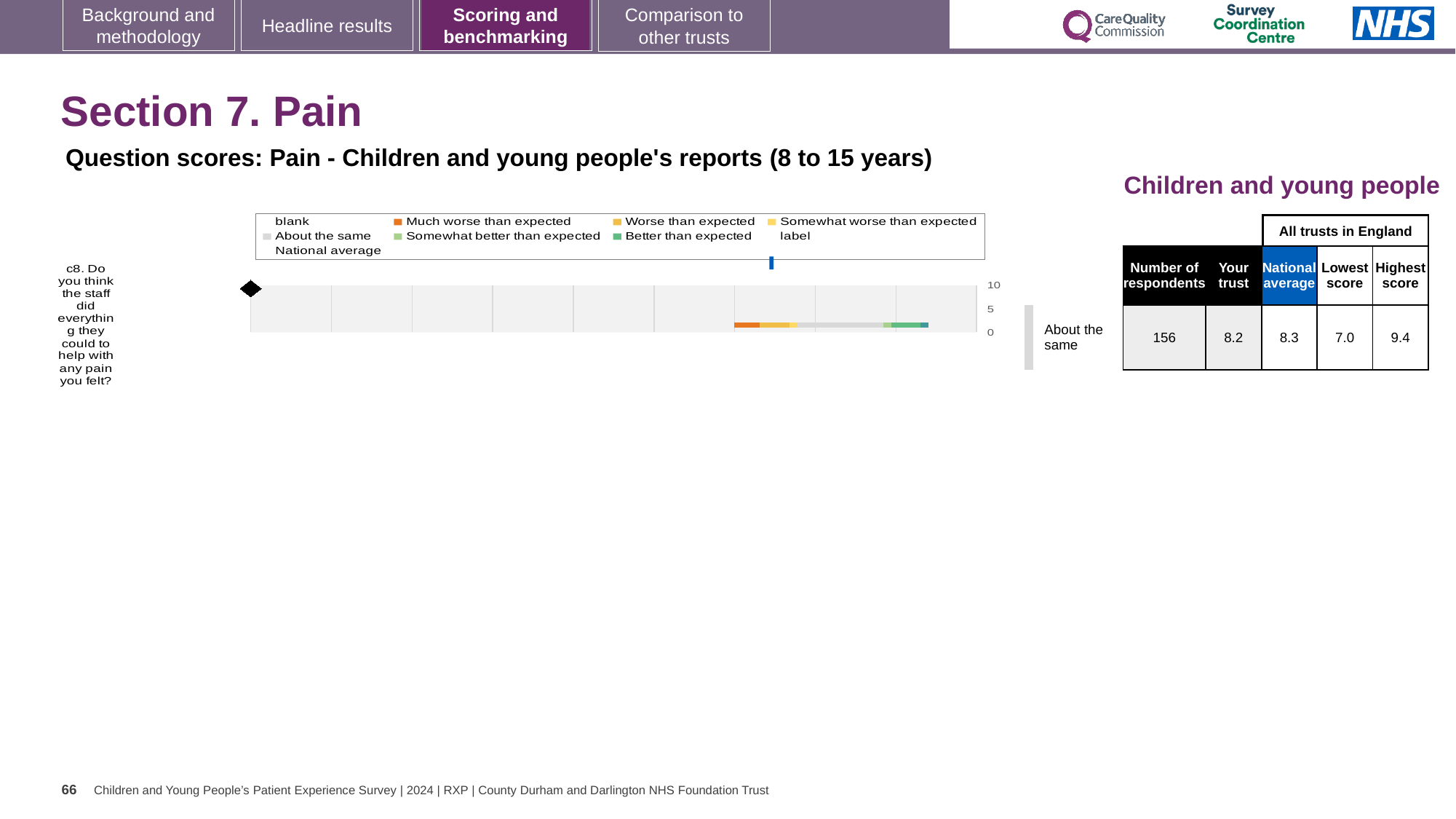
What is the label of the single category plotted on the chart? c8. Do you think the staff did everything they could to help with any pain you felt? What is the highest tick value shown on the chart's axis? 10 In the table beside the chart, what is the lowest score among all trusts in England for question c8? 7.0 In the table beside the chart, which is larger for question c8: the 'Your trust' score or the national average? National average In the table beside the chart, how many respondents answered question c8? 156 In the table beside the chart, what is the national average score for question c8? 8.3 How many question categories are plotted on the chart? 1 In the table beside the chart, what is the 'Your trust' score for question c8? 8.2 What kind of chart is shown on the slide? bar chart In the table beside the chart, what is the difference between the highest score and the lowest score for question c8? 2.4 What colour does the legend use for 'Much worse than expected'? orange In the table beside the chart, what is the highest score among all trusts in England for question c8? 9.4